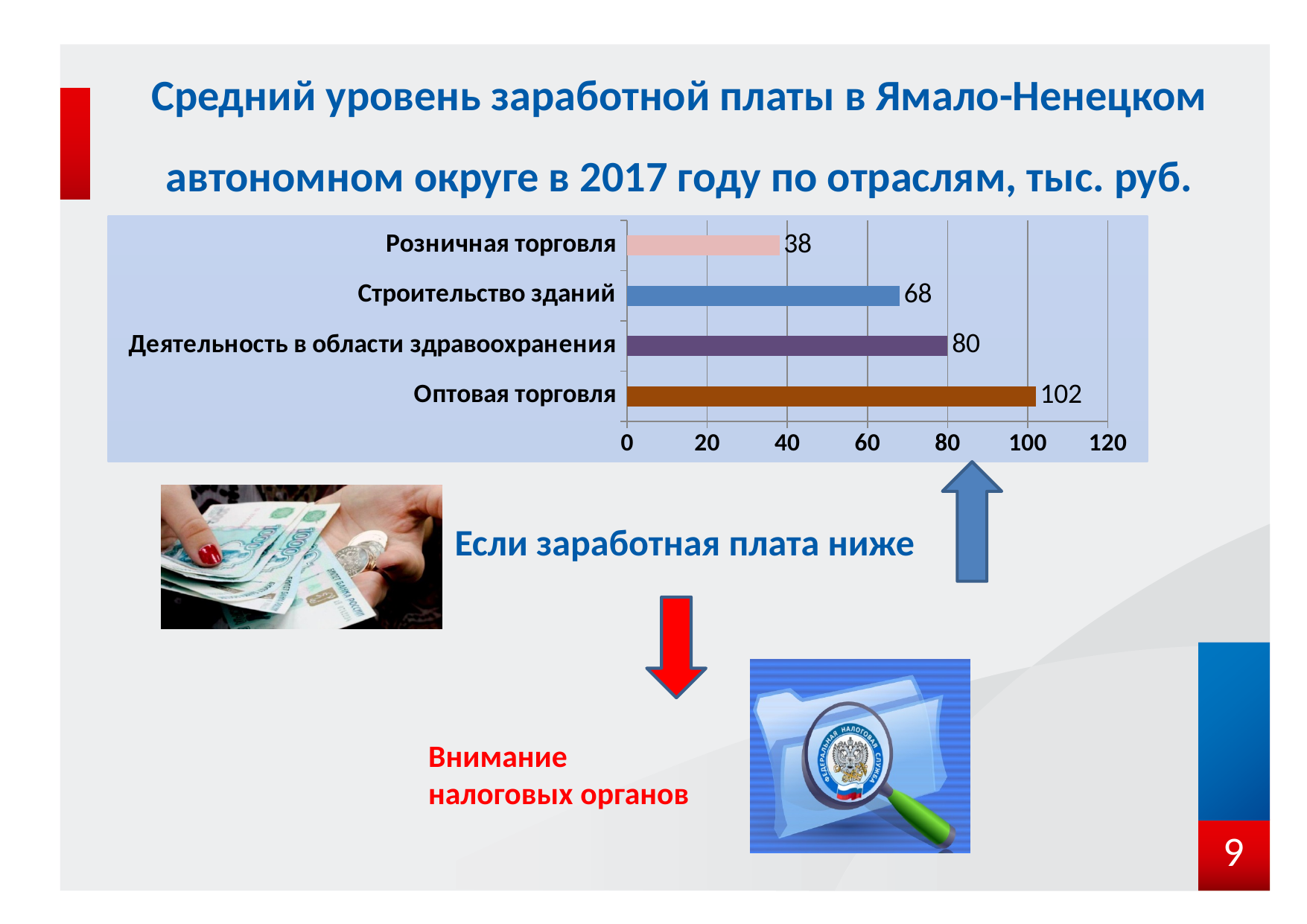
What is the value for Строительство зданий? 68 What is the value for Деятельность в области здравоохранения? 80 What is the difference between the values for Оптовая торговля and Розничная торговля? 64 What is the value for Оптовая торговля? 102 How many categories are shown in the chart? 4 Which is larger, the value for Строительство зданий or the value for Деятельность в области здравоохранения? Деятельность в области здравоохранения What is the difference between the values for Деятельность в области здравоохранения and Строительство зданий? 12 Which category has the highest value? Оптовая торговля Which category has the lowest value? Розничная торговля Is the value for Оптовая торговля greater or less than 100? greater What is the value for Розничная торговля? 38 What kind of chart is shown on the slide? bar chart